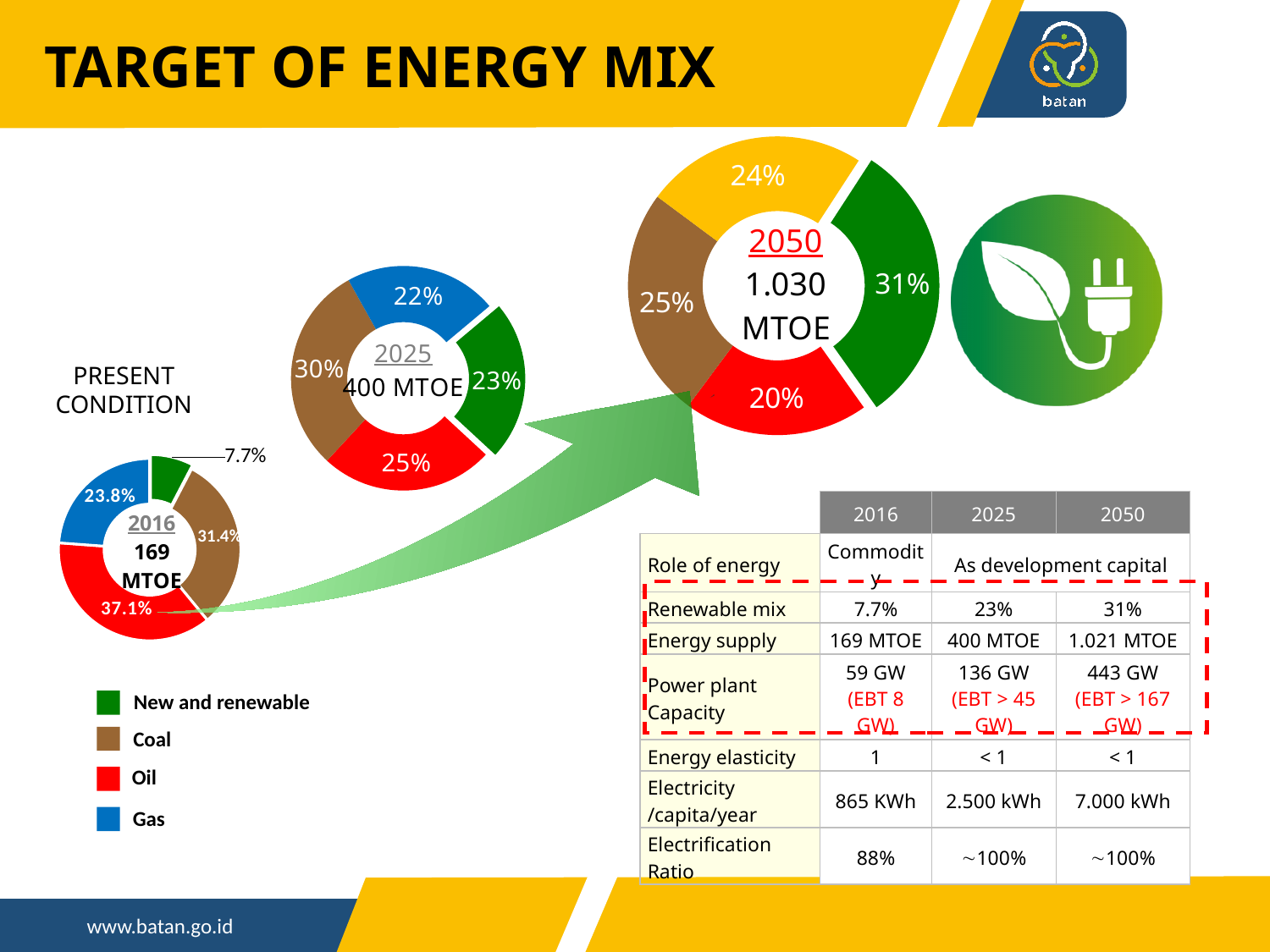
In the 2016 donut chart, what share does Oil have? 37.1% In the 2025 donut chart, what share does Gas have? 22% In the 2016 donut chart, which category has the largest share? Oil In the 2050 donut chart, what share does New and renewable have? 31% In the 2025 donut chart, what share does Coal have? 30% In the 2016 donut chart, which category has the smallest share? New and renewable In the 2016 donut chart, what is the difference between the Coal share and the Gas share? 7.6% In the 2016 donut chart, what share does New and renewable have? 7.7% How many slices does the 2050 donut chart have? 4 In the 2050 donut chart, what share does Oil have? 20% In the 2025 donut chart, which is larger, the Oil share or the New and renewable share? Oil What type of chart is used to show the energy mix for each year? Pie (donut) chart